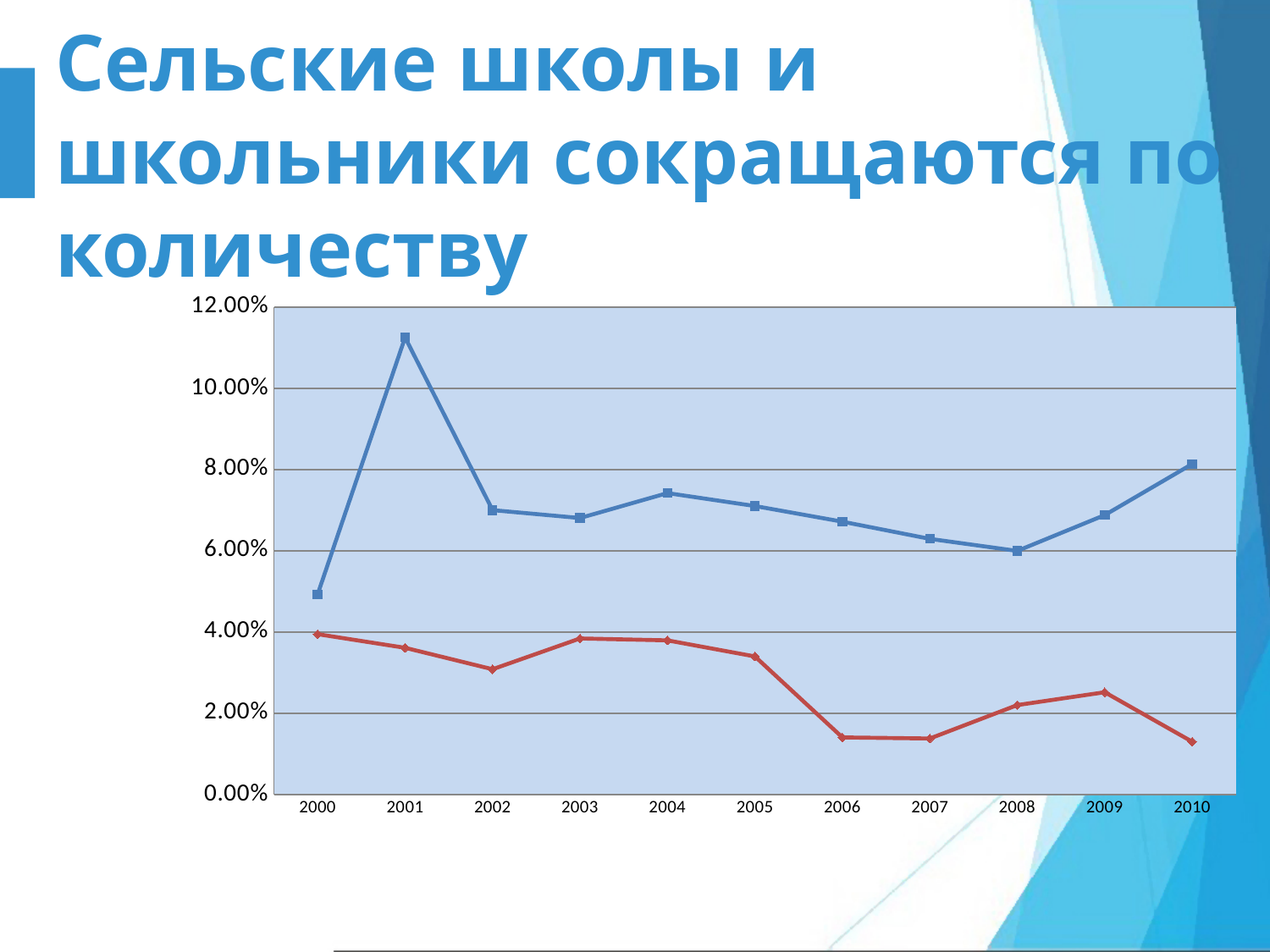
Is the value of the blue line in 2001 greater or less than 10.00%? greater Is the value of the red line in 2009 greater or less than 2.00%? greater In 2005, which line has the larger value, the blue line or the red line? the blue line How many lines (series) are plotted on the chart? 2 How many years are plotted along the x axis of the chart? 11 What kind of chart is shown on the slide? line chart What is the highest value shown on the y axis of the chart? 12.00% In which year does the blue line reach its highest value? 2001 Is the value of the red line in 2006 greater or less than 2.00%? less In which year does the blue line have its lowest value? 2000 Does the red line overall rise or fall from 2000 to 2010? fall